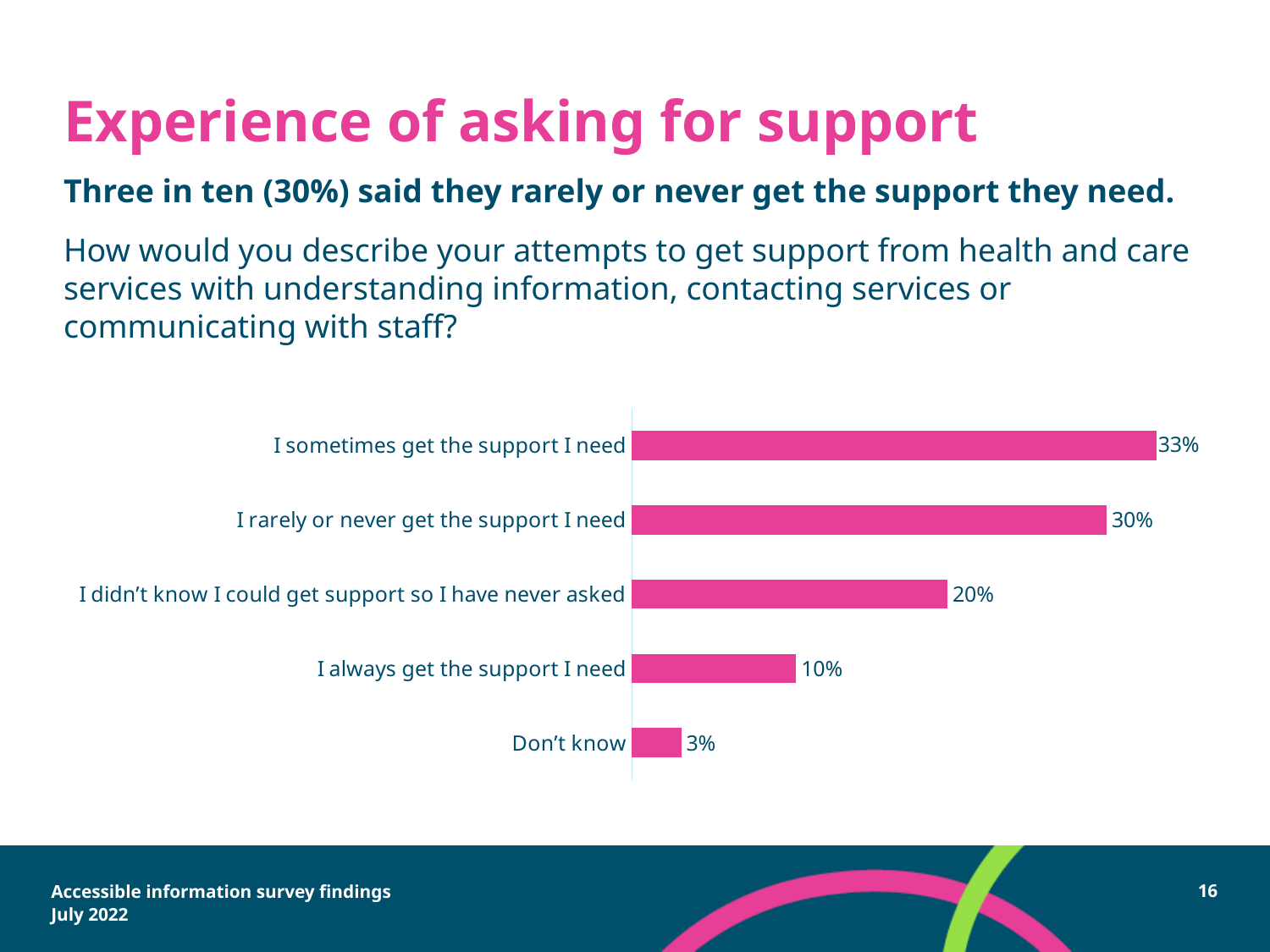
How many response categories are shown in the chart? 5 What percentage of respondents said 'I sometimes get the support I need'? 33% What type of chart is shown on the slide? Bar chart What percentage of respondents said 'I didn't know I could get support so I have never asked'? 20% What colour are the bars in the chart? Pink What percentage of respondents said 'I always get the support I need'? 10% Which response has the highest percentage? I sometimes get the support I need What percentage of respondents said 'I rarely or never get the support I need'? 30% What is the difference in percentage points between 'I rarely or never get the support I need' and 'I always get the support I need'? 20 percentage points What percentage of respondents answered 'Don't know'? 3% Which response has the lowest percentage? Don't know Which is larger: the value for 'I didn't know I could get support so I have never asked' or the value for 'I always get the support I need'? I didn't know I could get support so I have never asked